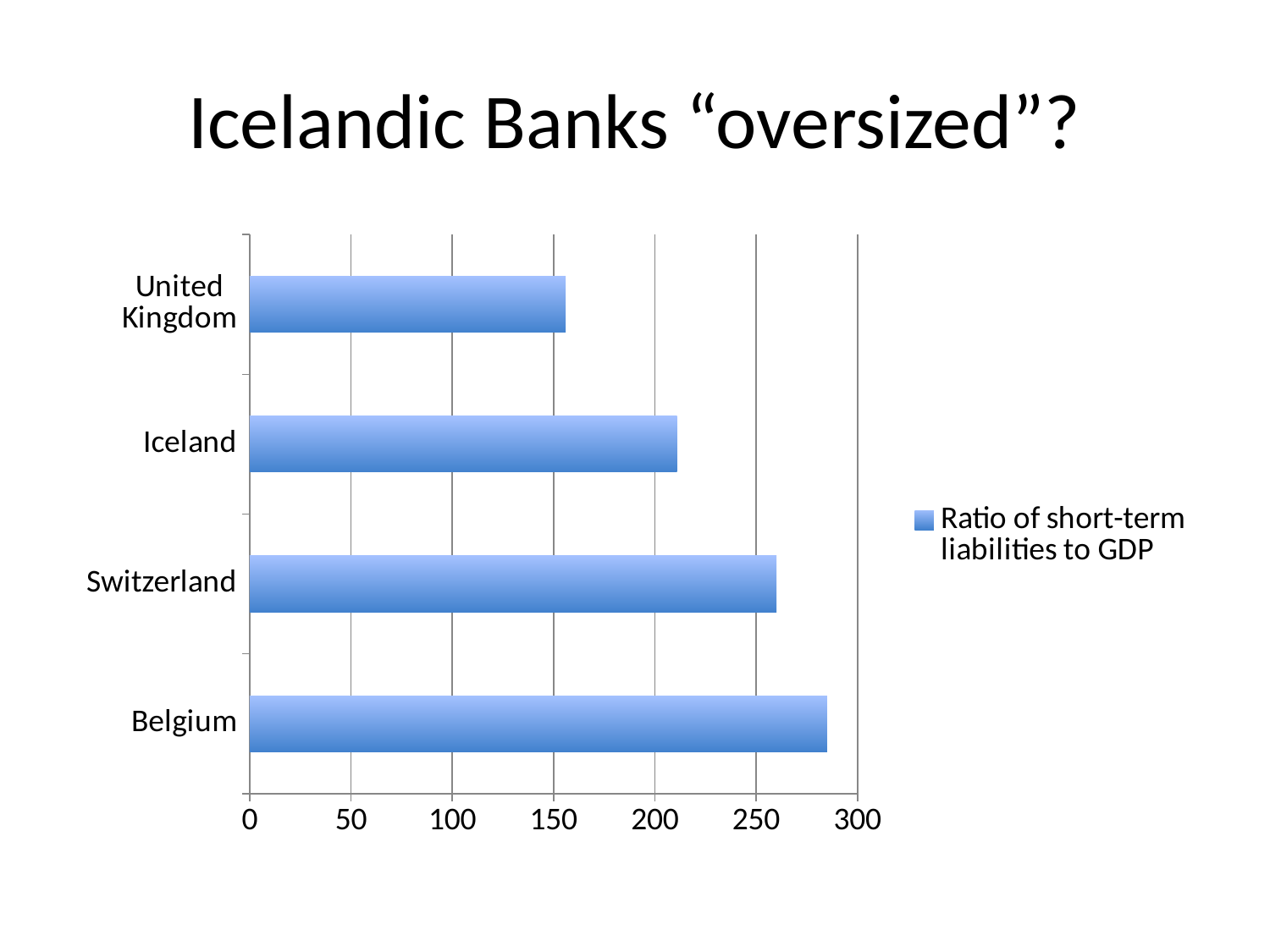
What is the title of the slide? Icelandic Banks "oversized"? Is the value for the United Kingdom greater or less than 200? less Which country has the lowest ratio of short-term liabilities to GDP? United Kingdom How many series does the legend list? 1 Which has a larger ratio of short-term liabilities to GDP, Switzerland or Iceland? Switzerland Is the value for Iceland greater or less than 200? greater Is the value for Belgium greater or less than 300? less What kind of chart is shown on the slide? bar chart How many countries are shown in the chart? 4 Which has a larger ratio of short-term liabilities to GDP, Iceland or the United Kingdom? Iceland Which country has the highest ratio of short-term liabilities to GDP? Belgium